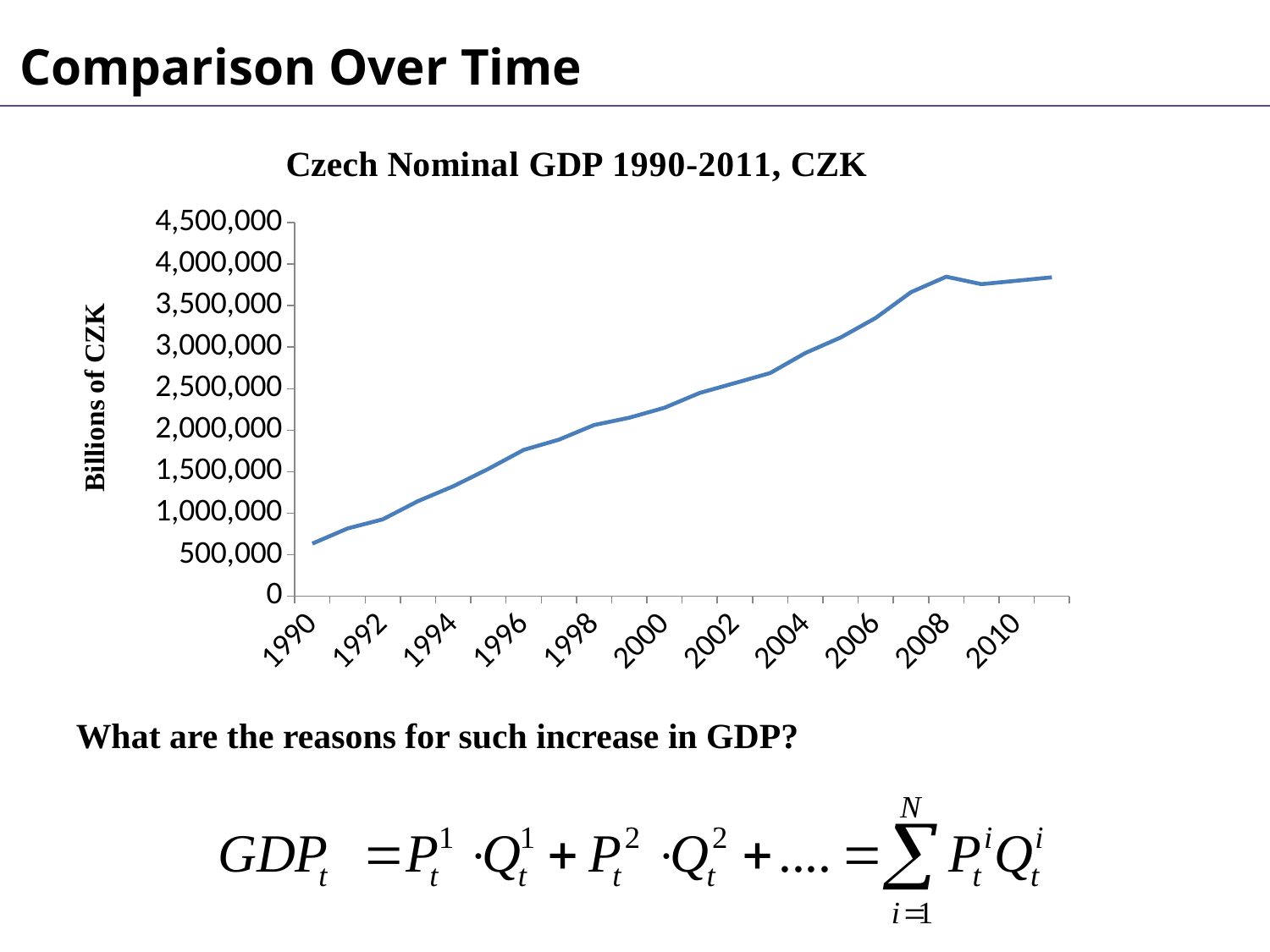
Is the value for 1990 greater or less than 1,000,000? less Does the plotted GDP line generally rise or fall from 1990 to 2011? rise Is the value for 2004 greater or less than 2,500,000? greater What is the label on the vertical axis of the chart? Billions of CZK Which year has the lowest GDP value on the chart? 1990 Which year has the higher GDP value, 1992 or 2002? 2002 What is the highest value shown on the vertical axis? 4,500,000 Which year has the higher GDP value, 2008 or 2009? 2008 Is the value for 2008 greater or less than 3,500,000? greater What kind of chart is shown on the slide? line chart What is the title of the chart? Czech Nominal GDP 1990-2011, CZK